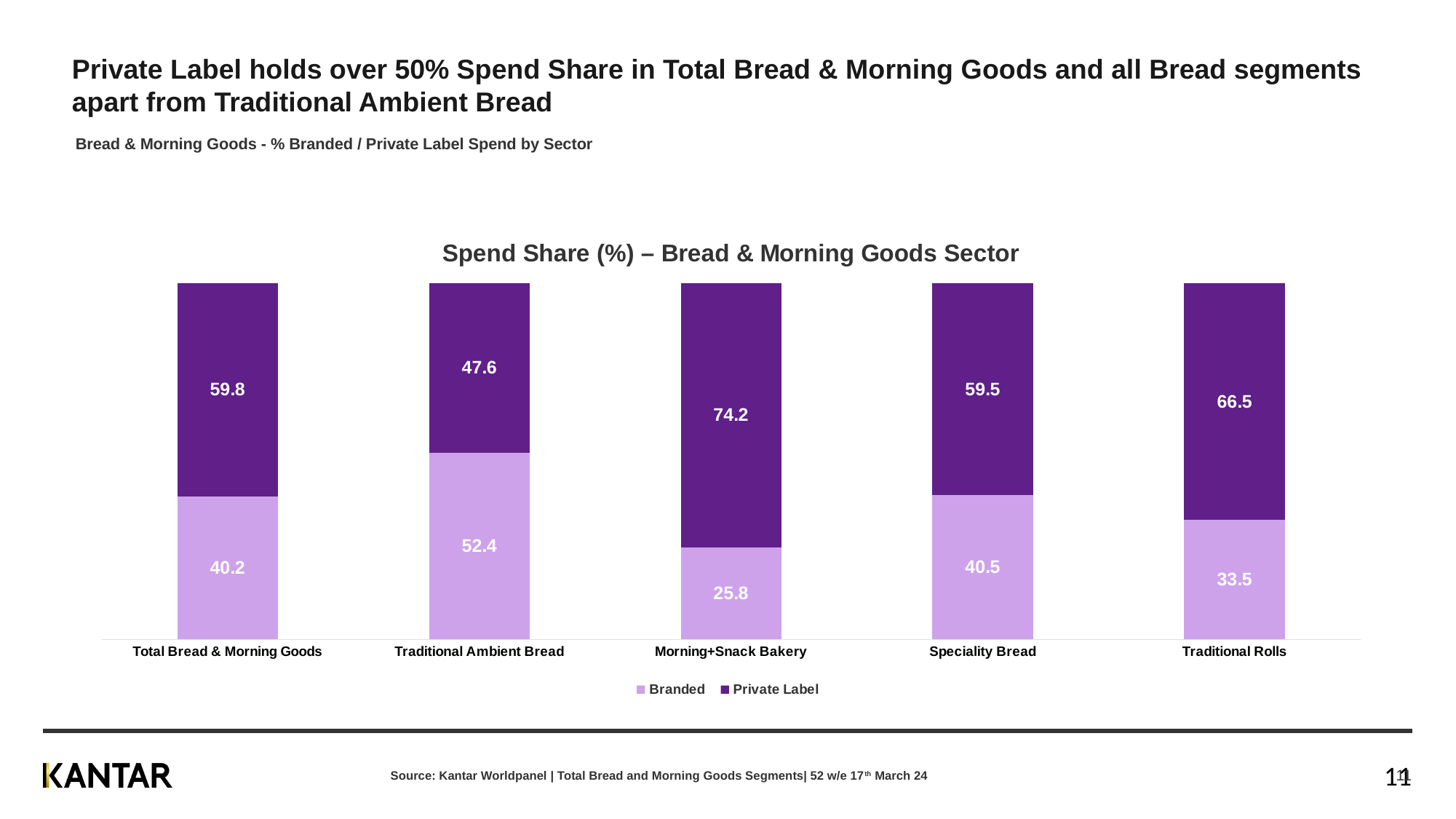
What is the Branded spend share for Traditional Rolls? 33.5 What kind of chart is shown? Stacked bar chart Which sector has the lowest Branded spend share? Morning+Snack Bakery Which is larger for Speciality Bread, the Branded share or the Private Label share? Private Label What is the Private Label spend share for Morning+Snack Bakery? 74.2 What is the difference between the Private Label and Branded spend shares for Total Bread & Morning Goods? 19.6 What is the total of the stacked bar for Traditional Rolls? 100 Which sector has the highest Private Label spend share? Morning+Snack Bakery What is the title of the chart? Spend Share (%) – Bread & Morning Goods Sector How many series does the legend list? 2 What is the Branded spend share for Traditional Ambient Bread? 52.4 How many sectors are shown on the x axis? 5